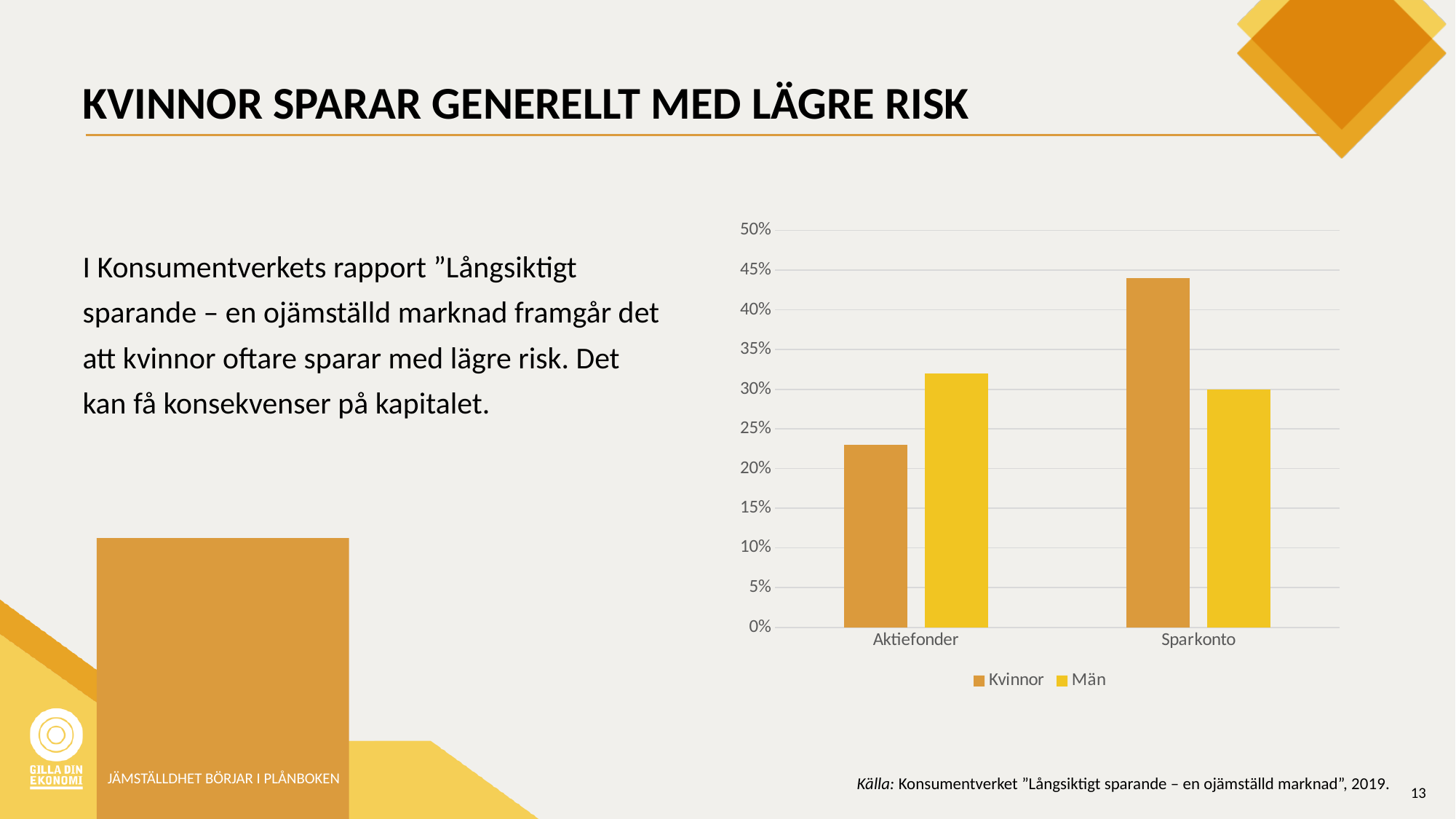
What are the two entries listed in the chart legend? Kvinnor and Män Is the value for Män in Sparkonto greater or less than 35%? less For Aktiefonder, which is larger: Kvinnor or Män? Män Is the value for Kvinnor in Aktiefonder greater or less than 25%? less Is the value for Män in Aktiefonder greater or less than 30%? greater How many categories are shown on the x axis of the chart? 2 For Sparkonto, which is larger: Kvinnor or Män? Kvinnor Which series has the highest bar in the chart? Kvinnor How many series does the chart legend list? 2 Which bar is the lowest in the chart? Kvinnor for Aktiefonder What kind of chart is shown on the slide? bar chart